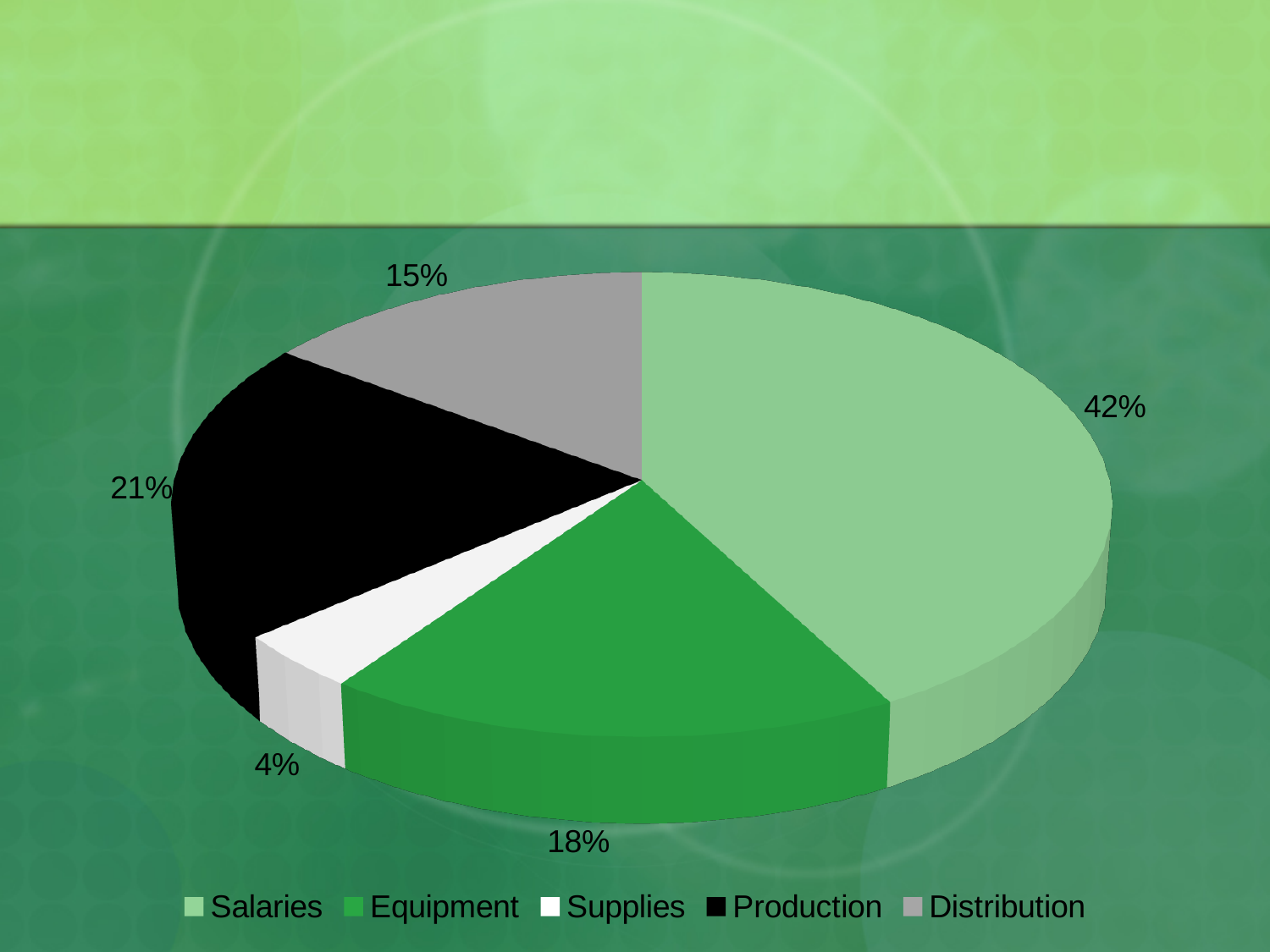
Which category has the smallest share of the pie? Supplies What percentage of the pie does Production account for? 21% What kind of chart is shown on the slide? Pie chart What percentage of the pie does Supplies account for? 4% Which category has the largest share of the pie? Salaries Which category is shown in black in the pie chart? Production What is the difference in percentage points between Salaries and Production? 21 How many categories does the pie chart have? 5 What percentage of the pie does Distribution account for? 15% Which is larger, the share for Equipment or the share for Distribution? Equipment What percentage of the pie does Salaries account for? 42% What percentage of the pie does Equipment account for? 18%